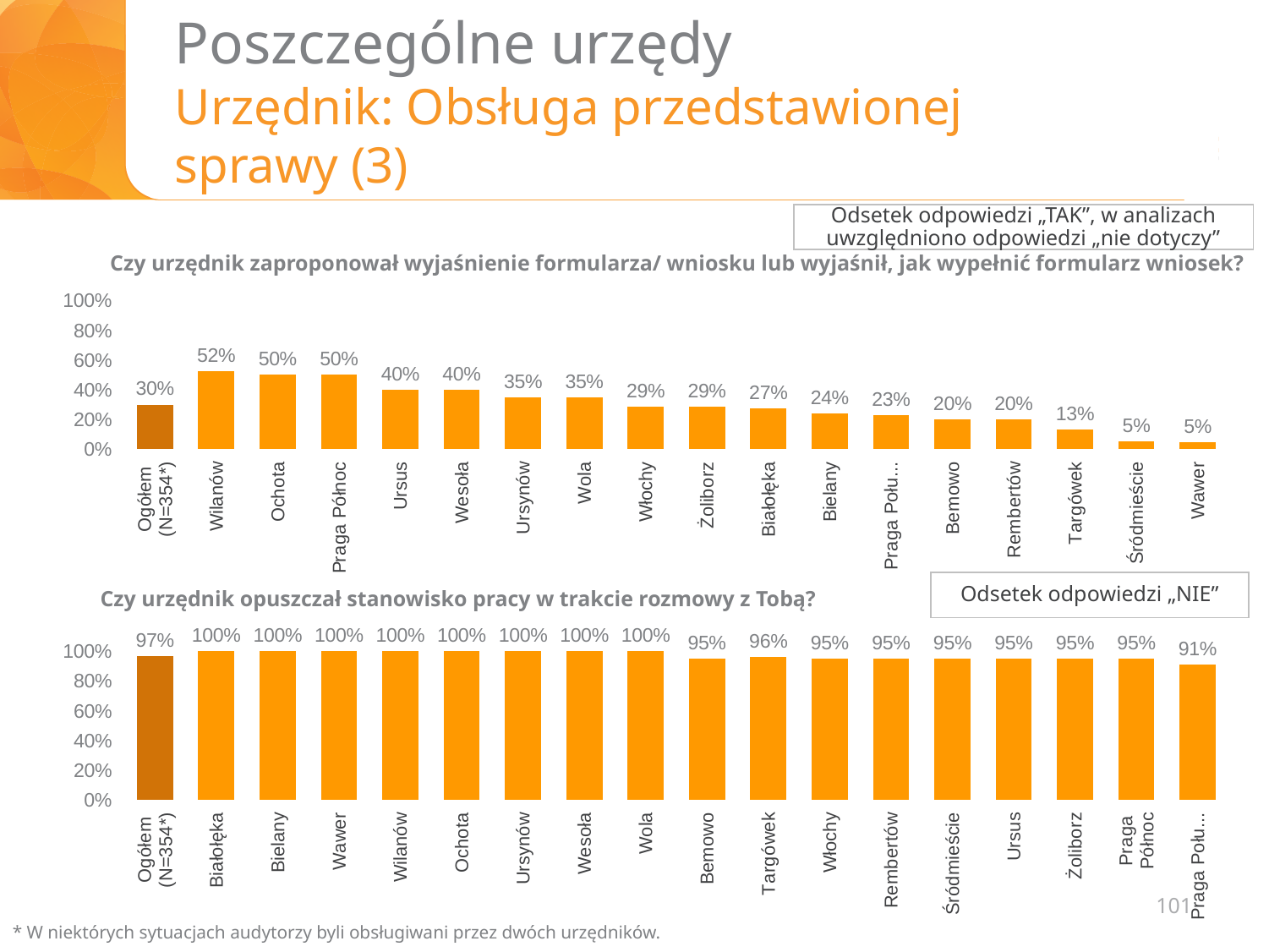
In the bottom chart, what is the value for Targówek? 96% In the top chart, which district has the highest value? Wilanów In the bottom chart, what is the value for Ogółem (N=354*)? 97% In the top chart, what is the value for Wilanów? 52% In the top chart, what is the value for Ogółem (N=354*)? 30% In the bottom chart, which is larger, the value for Bielany or the value for Żoliborz? Bielany In the top chart, what is the difference between the values for Ochota and Targówek? 37% In the top chart, how many bars are shown? 18 What type of chart is the top chart? Bar chart In the bottom chart, what is the difference between the values for Wola and Bemowo? 5% What is the title of the bottom chart? Czy urzędnik opuszczał stanowisko pracy w trakcie rozmowy z Tobą? In the top chart, which is larger, the value for Ursus or the value for Bielany? Ursus